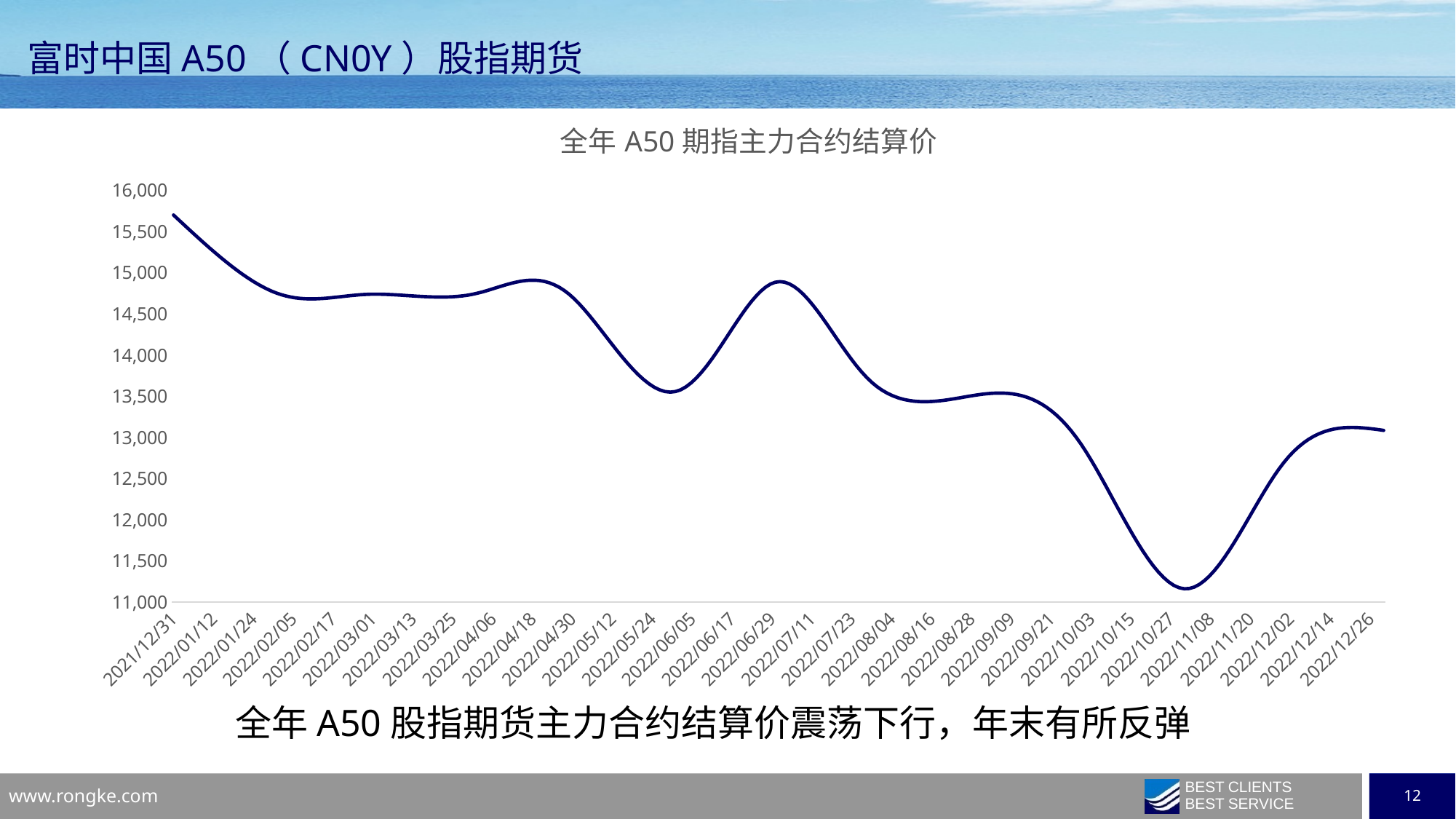
Around which date label is the settlement price lowest? 2022/10/27 Is the value at 2022/02/05 greater or less than 14,500? greater Which is higher, the value at 2021/12/31 or the value at 2022/12/26? 2021/12/31 Is the value at 2021/12/31 greater or less than 15,500? greater What kind of chart is shown on the slide? line chart What is the title of the chart? 全年 A50 期指主力合约结算价 What is the highest tick value shown on the y axis? 16,000 Which is higher, the value at 2022/06/29 or the value at 2022/10/27? 2022/06/29 Overall, does the settlement price rise or fall from 2021/12/31 to 2022/12/26? fall Is the value at 2022/10/27 greater or less than 11,500? less On which date label is the settlement price highest? 2021/12/31